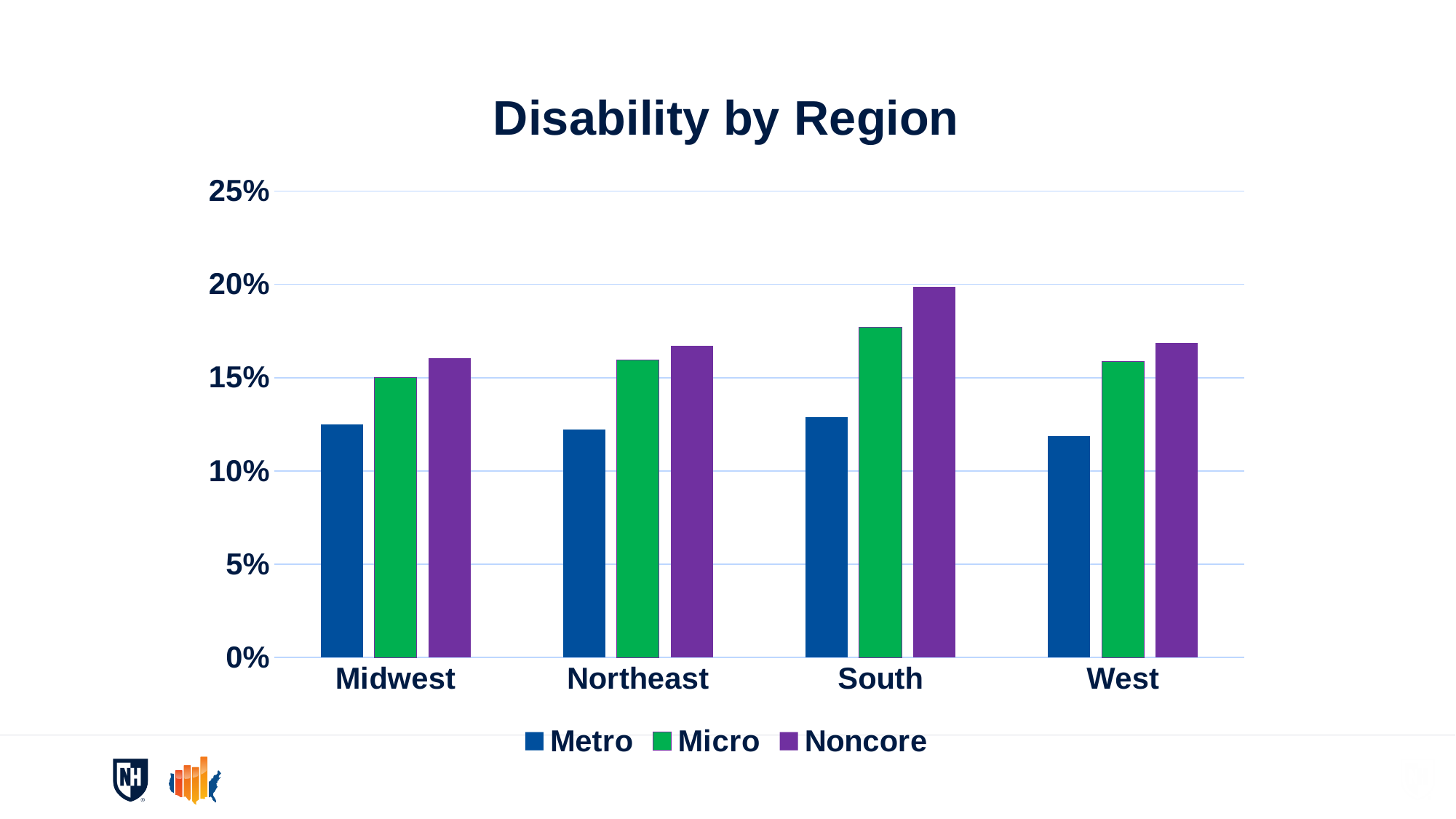
Is the Noncore value for the South greater or less than 15%? greater Which region has the highest Noncore value? South What is the title of the chart? Disability by Region In the South, which series has the highest value? Noncore How many series does the legend list? 3 Which is larger, the Noncore value for the South or the Noncore value for the Midwest? South Which region has the highest Micro value? South How many regions are shown on the x axis? 4 Which colour represents the Micro series in the legend? green Is the Metro value for the West greater or less than 10%? greater Is the Metro value for the Midwest greater or less than 15%? less What kind of chart is shown on the slide? bar chart